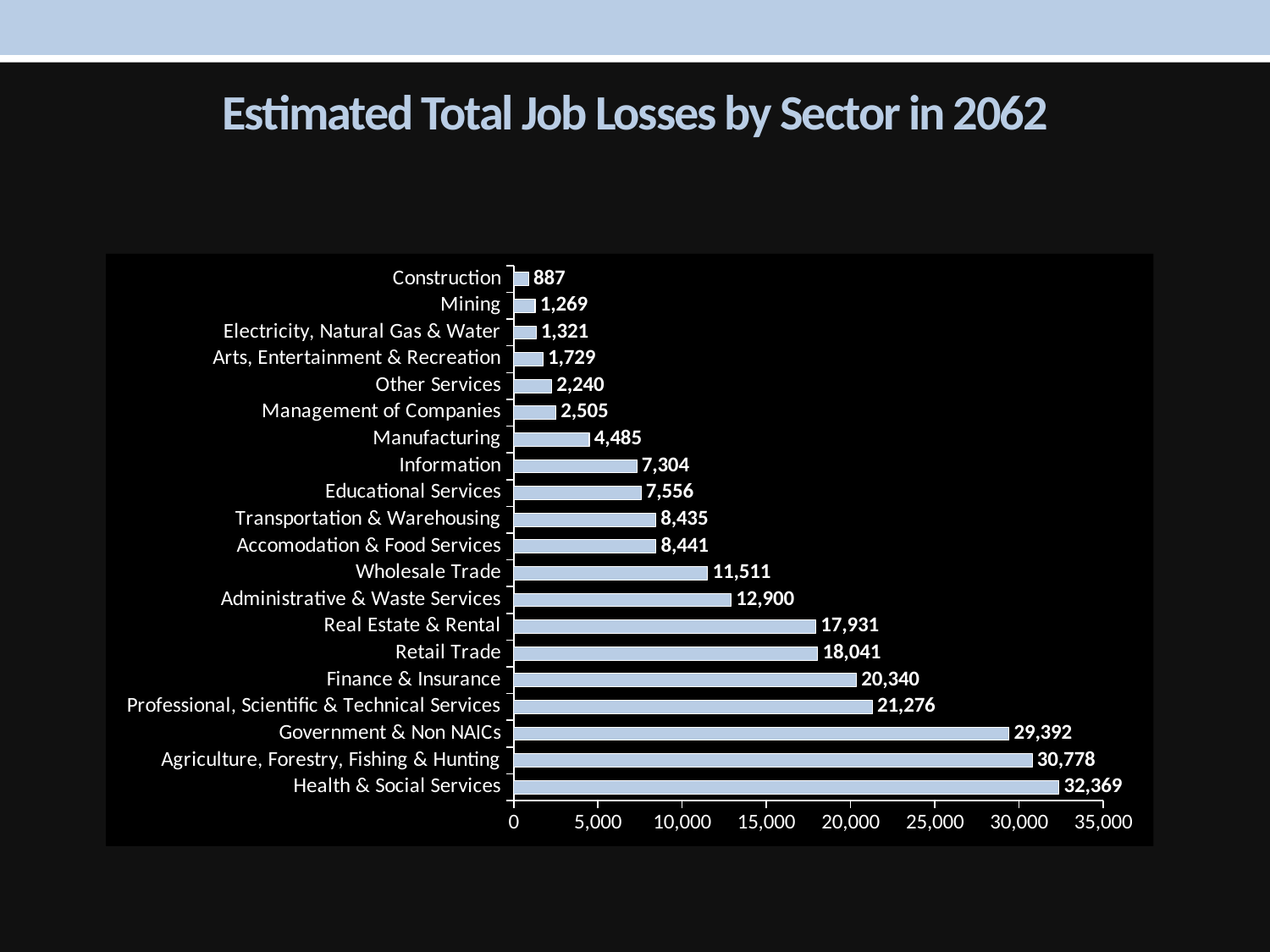
What is the estimated total job loss for Retail Trade? 18,041 What is the difference in estimated job losses between Government & Non NAICs and Finance & Insurance? 9,052 What kind of chart is shown on the slide? Bar chart Which sector has the highest estimated job losses? Health & Social Services What is the title of the chart on the slide? Estimated Total Job Losses by Sector in 2062 What is the estimated total job loss for Health & Social Services? 32,369 Which sector has the lowest estimated job losses? Construction Which has higher estimated job losses, Wholesale Trade or Information? Wholesale Trade What is the difference in estimated job losses between Mining and Construction? 382 What is the estimated total job loss for Manufacturing? 4,485 How many sectors are shown in the chart? 20 Is the value for Agriculture, Forestry, Fishing & Hunting greater or less than 25,000? greater